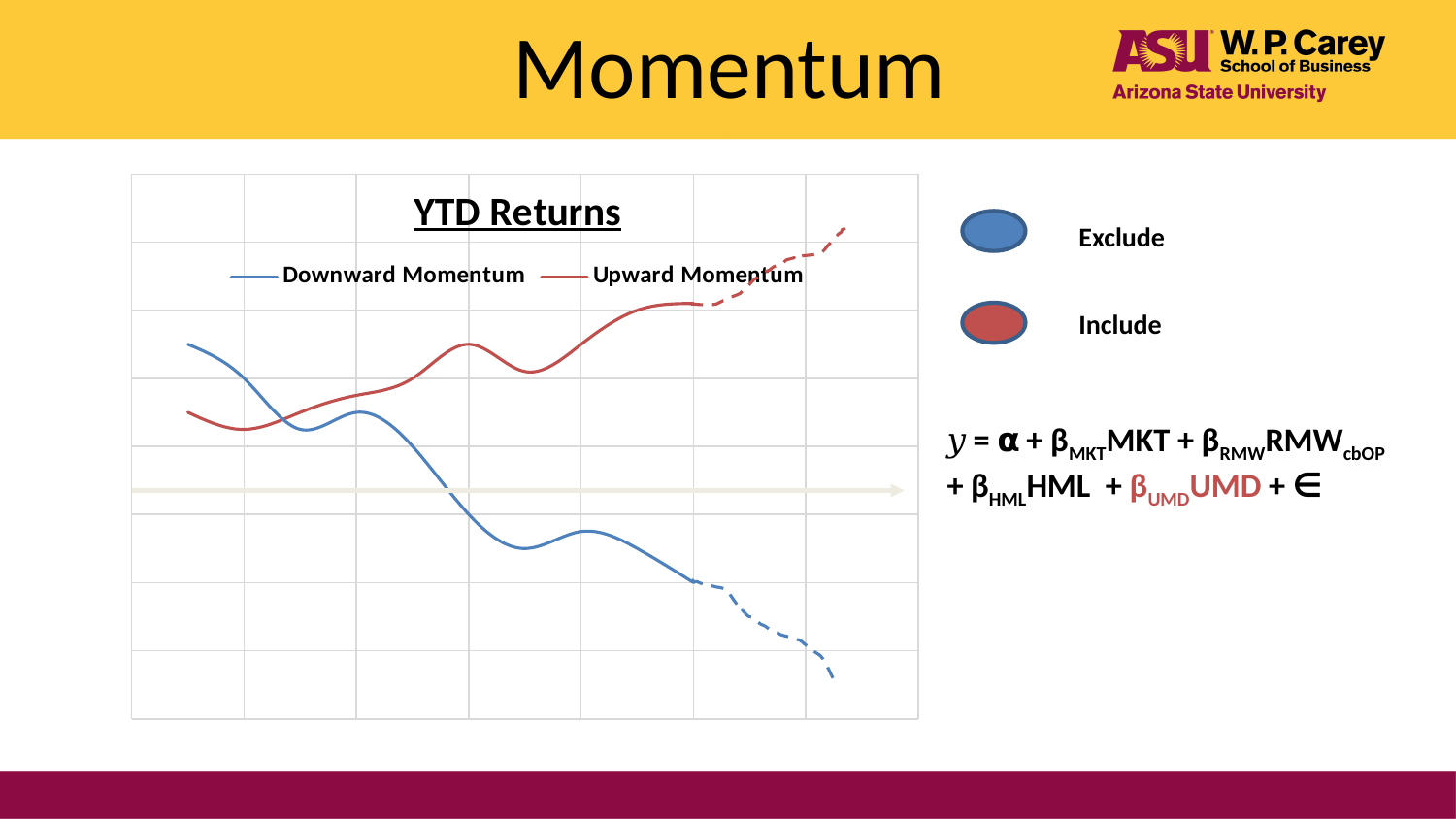
How many series does the chart's legend list? 2 Which series is drawn in red? Upward Momentum What kind of chart is shown on the slide? line chart Does the Upward Momentum line rise or fall overall from left to right? rise At the left end of the chart, which series starts higher, Downward Momentum or Upward Momentum? Downward Momentum At the right end of the chart, which series has the higher value, Downward Momentum or Upward Momentum? Upward Momentum What is the title of the chart? YTD Returns Does the Downward Momentum line rise or fall overall from left to right? fall